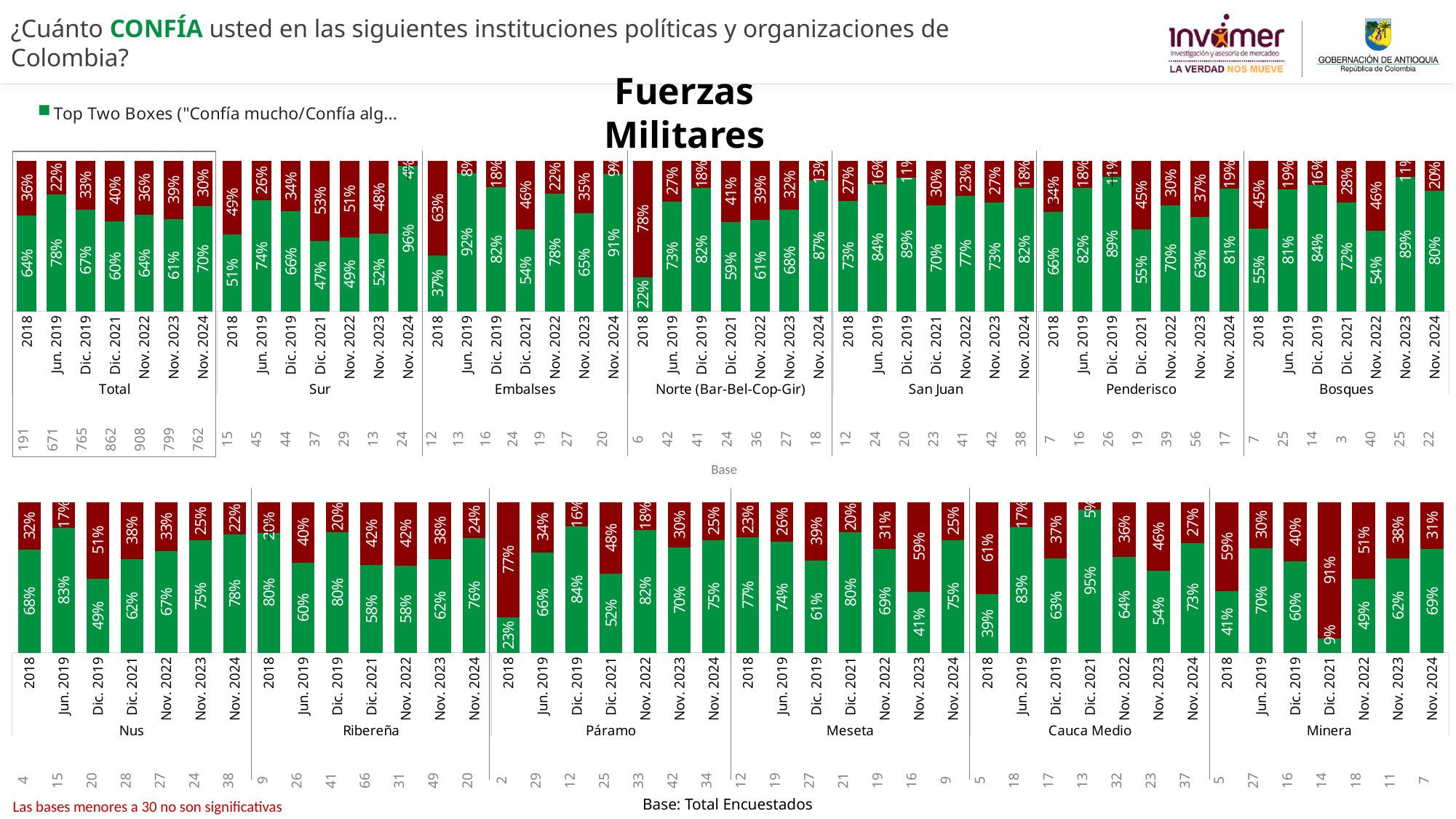
In the bottom chart, how many periods are shown for the Nus group? 7 In the top chart, what is the green (Top Two Boxes) value for Total in Nov. 2024? 70% In the top chart, which is larger: the green value for San Juan in Dic. 2019 or for Penderisco in Dic. 2021? San Juan in Dic. 2019 In the top chart, what is the difference between the green values for Total in Jun. 2019 and Dic. 2021? 18% In the bottom chart, what is the green value for Minera in Dic. 2021? 9% In the top chart, what is the green value for Norte (Bar-Bel-Cop-Gir) in 2018? 22% What type of chart is used on this slide? Stacked bar chart In the bottom chart, what is the red (upper segment) value for Meseta in Nov. 2023? 59% In the top chart, which period has the lowest green value within the Embalses group? 2018 In the top chart, which period has the highest green value within the Sur group? Nov. 2024 In the top chart, what is the base (number of respondents) shown for Total in Nov. 2024? 762 In the bottom chart, which period has the highest green value within the Cauca Medio group? Dic. 2021